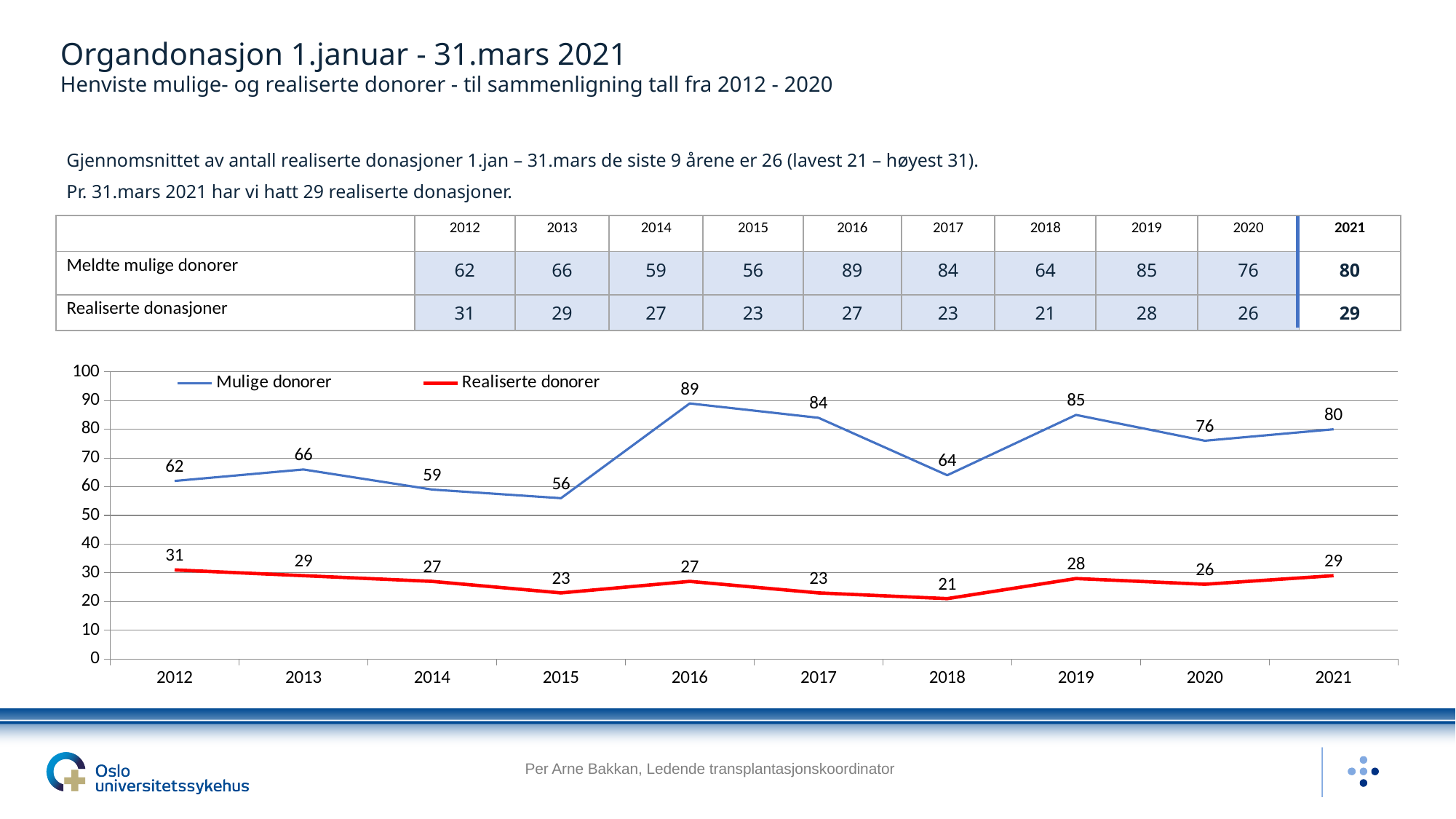
What kind of chart is shown on the slide? line chart Is the value for Mulige donorer in 2015 greater or less than 60? less What is the difference between Mulige donorer and Realiserte donorer in 2021? 51 What is the value for Mulige donorer in 2021? 80 In which year is Realiserte donorer lowest? 2018 In which year is Mulige donorer highest? 2016 What is the value for Mulige donorer in 2016? 89 Which colour is used for the Realiserte donorer line? red What is the value for Realiserte donorer in 2018? 21 Which is larger: Mulige donorer in 2019 or Mulige donorer in 2020? 2019 How many years are shown on the x axis of the chart? 10 How many series does the chart legend list? 2